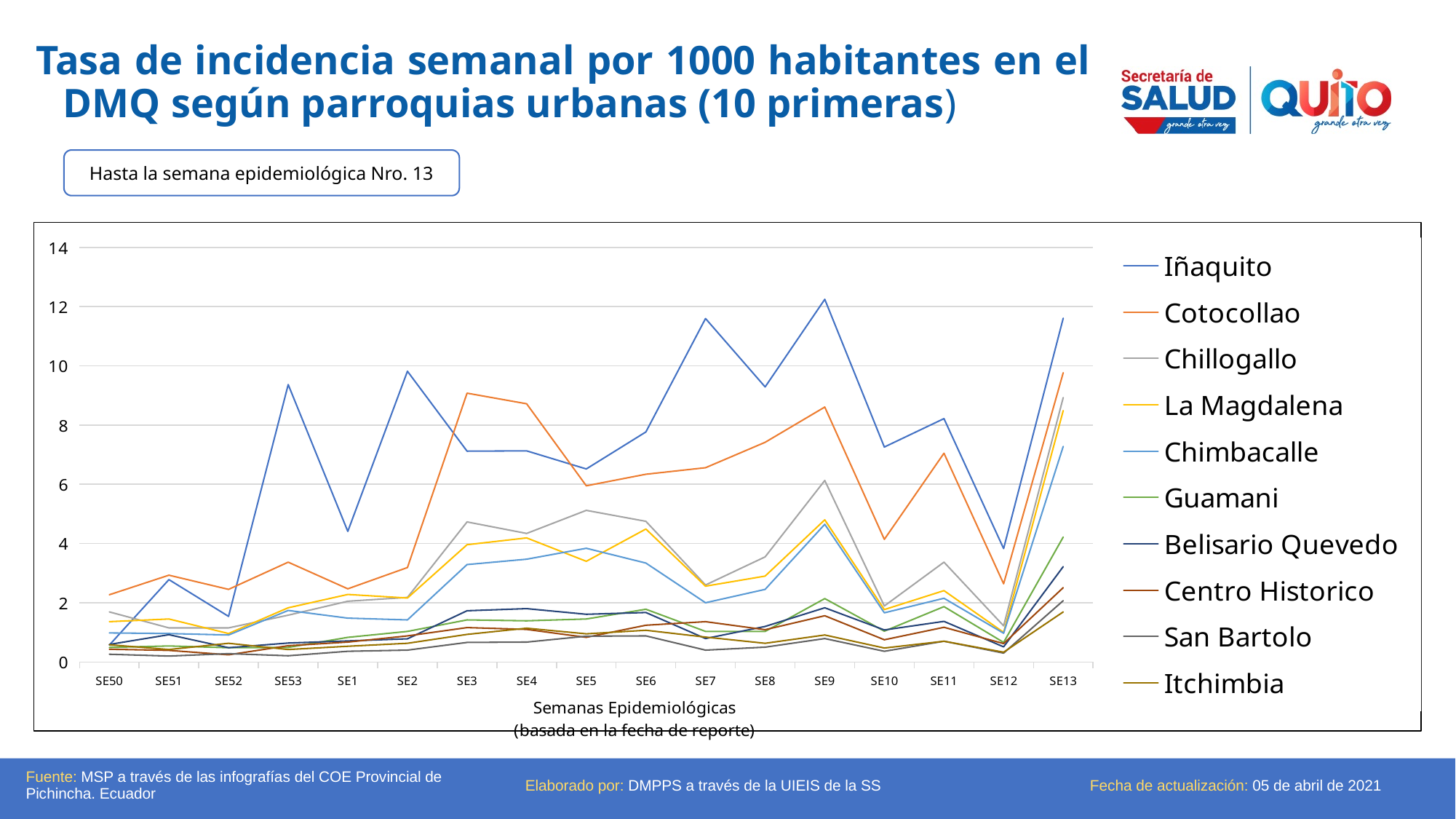
Is the value for Iñaquito at SE9 greater or less than 10? greater How many epidemiological weeks are plotted along the x axis? 17 Which series has the highest value at SE9? Iñaquito Does the Iñaquito line rise or fall from SE9 to SE12? Fall What kind of chart is shown on the slide? Line chart Is the value for Iñaquito at SE12 greater or less than 6? less Which series has the highest value at SE13? Iñaquito Is the value for Cotocollao at SE3 greater or less than 8? greater How many series does the legend list? 10 In which week does the Iñaquito line reach its highest value? SE9 At SE3, which is higher: Cotocollao or Iñaquito? Cotocollao What is the title of the x axis? Semanas Epidemiológicas (basada en la fecha de reporte)